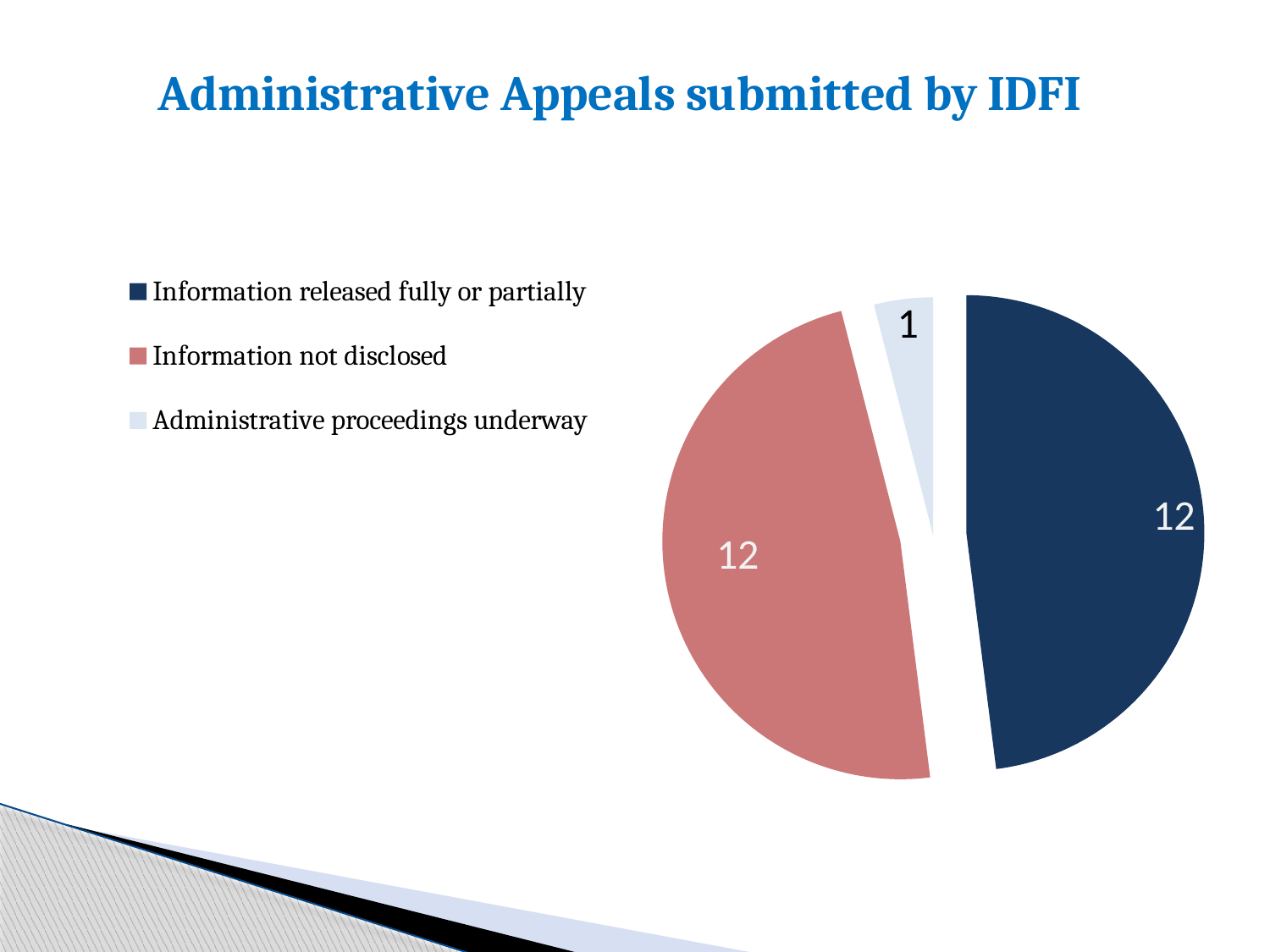
What is the value for "Administrative proceedings underway"? 1 What is the total of all the values shown in the pie chart? 25 Which is larger: "Information not disclosed" or "Administrative proceedings underway"? Information not disclosed What is the difference between the values for "Information released fully or partially" and "Administrative proceedings underway"? 11 How many entries does the legend list? 3 What is the value for "Information not disclosed"? 12 What is the value for "Information released fully or partially"? 12 How many categories does the pie chart show? 3 What type of chart is shown on the slide? Pie chart Which category has the smallest slice of the pie? Administrative proceedings underway What share of the pie does "Administrative proceedings underway" represent? 4% What is the title of the slide containing the chart? Administrative Appeals submitted by IDFI